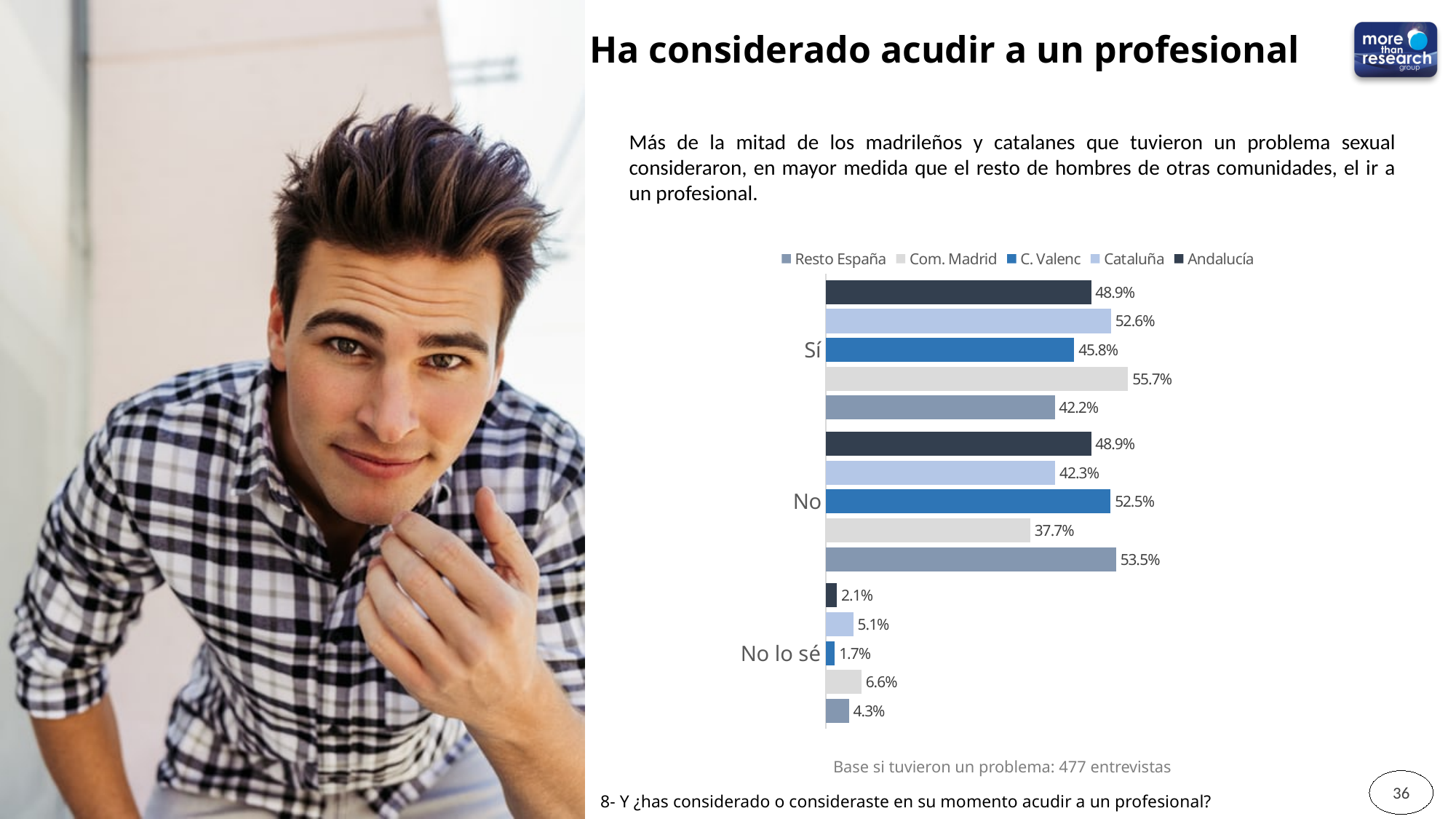
What is the value for Andalucía in the 'No lo sé' category? 2.1% How many series does the chart legend list? 5 What type of chart is shown on the slide? bar chart How many response categories are shown on the chart? 3 What is the difference between Com. Madrid and Resto España in the 'Sí' category? 13.5% What is the value for C. Valenc in the 'No lo sé' category? 1.7% What is the value for Resto España in the 'No' category? 53.5% In the 'No' category, which is larger: C. Valenc or Cataluña? C. Valenc What is the value for Com. Madrid in the 'Sí' category? 55.7% Which series has the lowest value in the 'No' category? Com. Madrid Which series has the highest value in the 'Sí' category? Com. Madrid What base is stated below the chart? Base si tuvieron un problema: 477 entrevistas